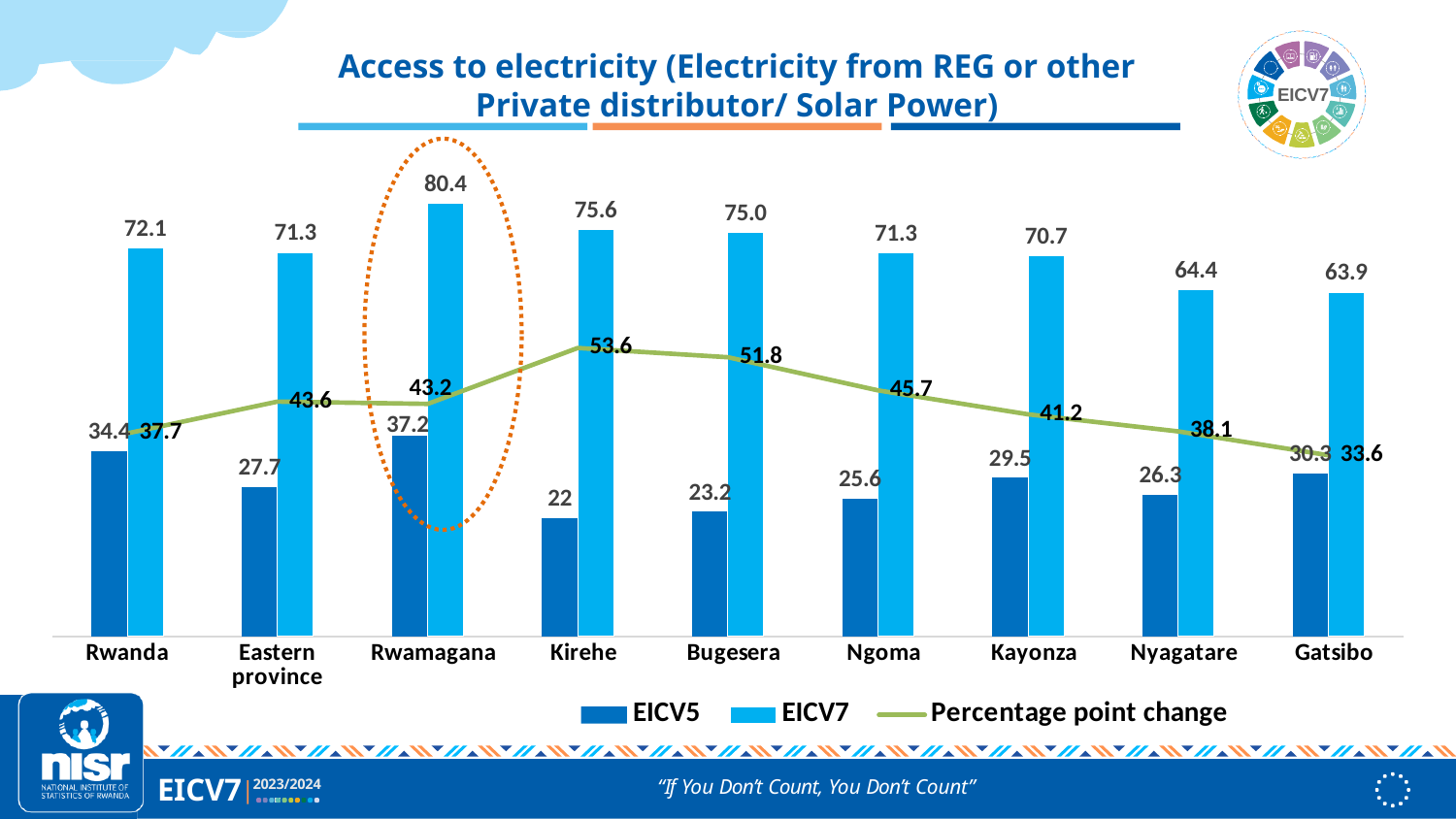
What is the EICV5 value for Rwanda? 34.4 Does the percentage point change line rise or fall from Kirehe to Gatsibo? fall How many categories are shown on the x axis? 9 Which is larger, the EICV7 value for Nyagatare or the EICV7 value for Kayonza? Kayonza What is the difference between the EICV7 and EICV5 values for Gatsibo? 33.6 What is the percentage point change for Bugesera? 51.8 Which category has the highest percentage point change? Kirehe Which category has the highest EICV7 value? Rwamagana How many series does the legend list? 3 What is the EICV7 value for Rwamagana? 80.4 Which category has the lowest EICV5 value? Kirehe What is the EICV5 value for Kirehe? 22